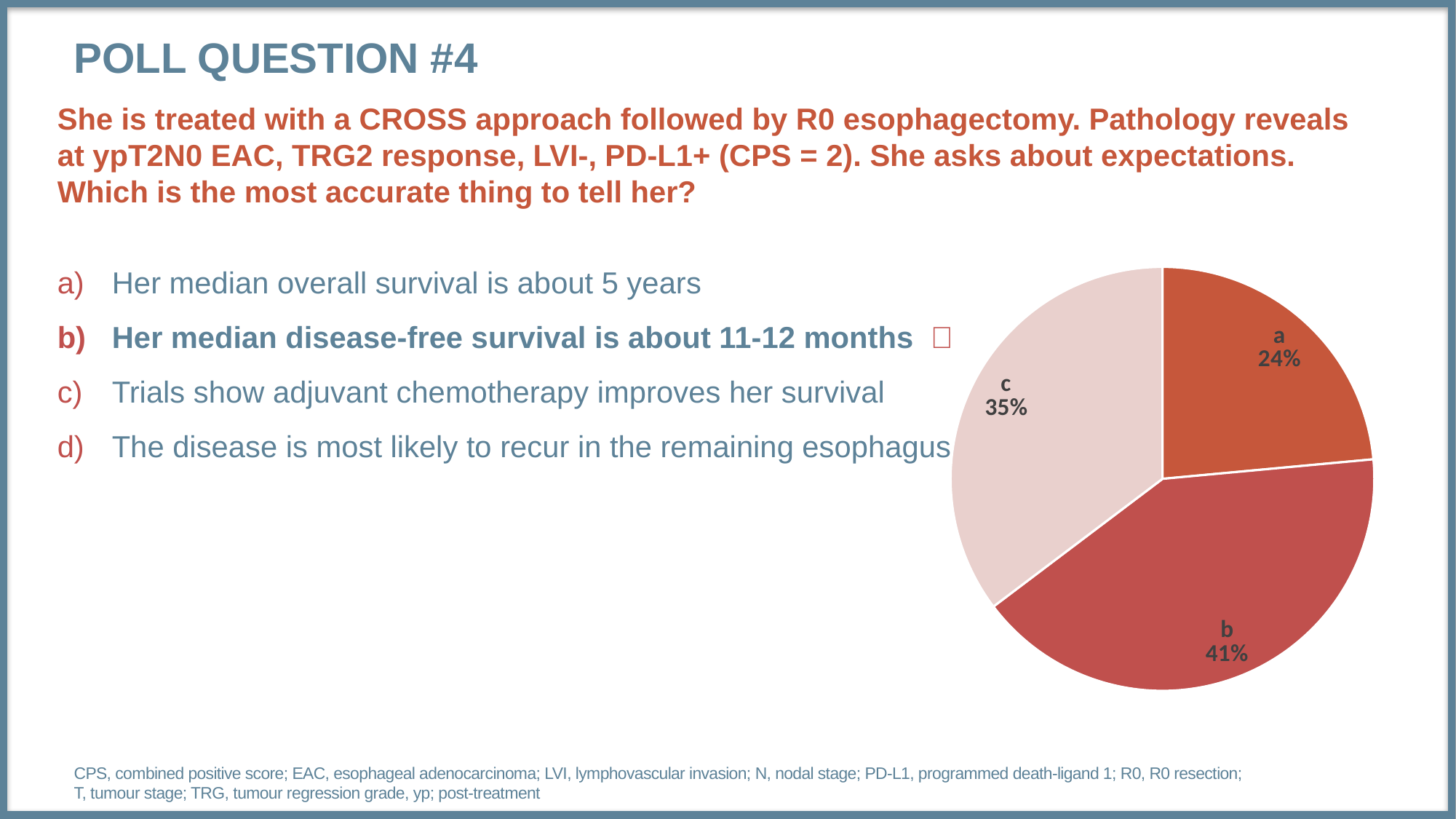
What is the difference in percentage points between slice b and slice c? 6 What percentage of the pie is labelled c? 35% What share of the pie does slice c represent? 35% What percentage of the pie is labelled b? 41% How many slices does the pie chart have? 3 Which slice of the pie chart is the lightest in colour? c Which slice of the pie chart is the smallest? a Which slice of the pie chart is the largest? b Which slice is larger, a or c? c What percentage of the pie is labelled a? 24% What kind of chart is shown on the slide? pie chart What is the difference in percentage points between slice b and slice a? 17